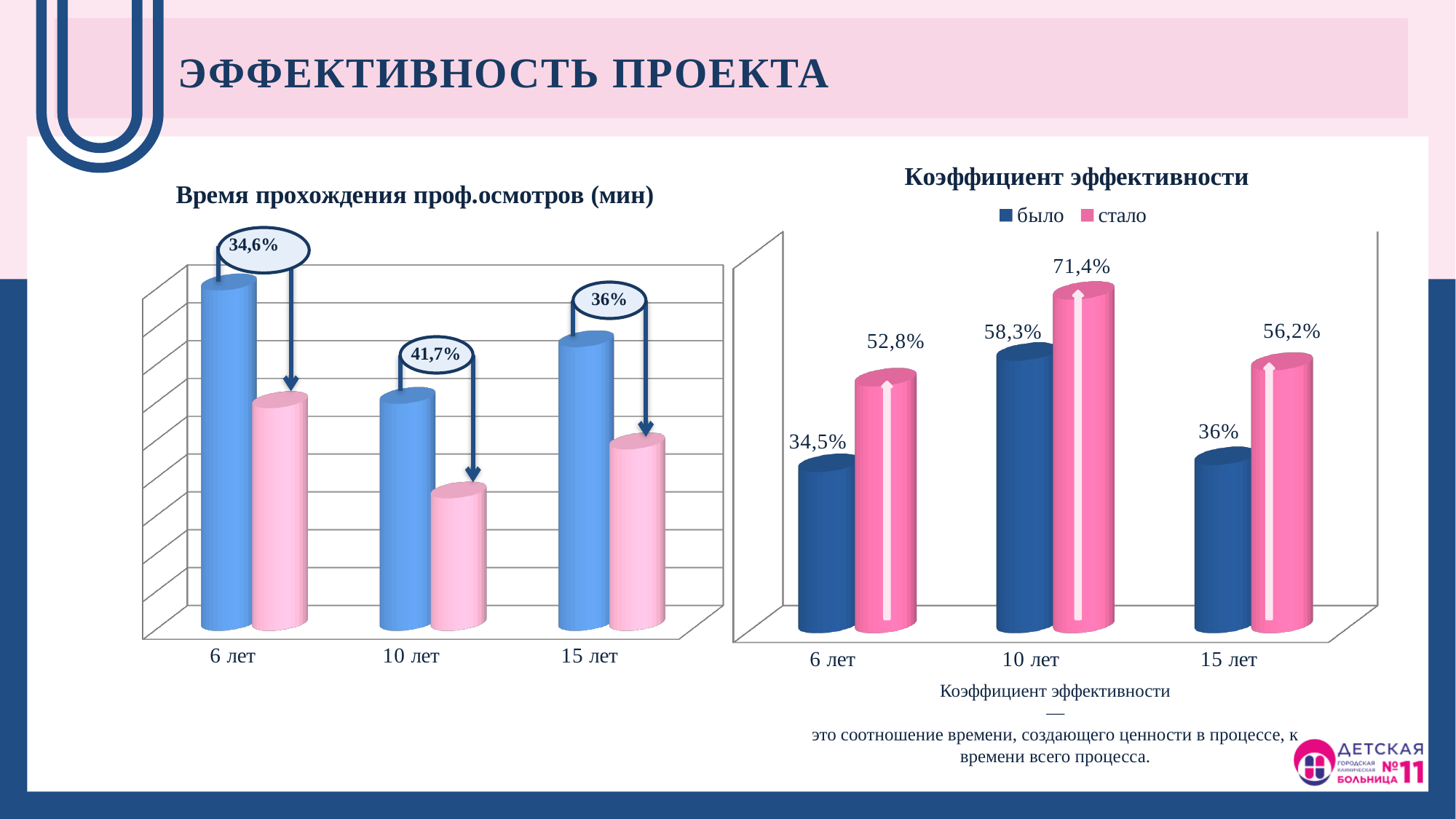
What kind of chart is the chart titled 'Время прохождения проф.осмотров (мин)'? Bar chart In the chart titled 'Коэффициент эффективности', what is the difference between 'стало' and 'было' at '10 лет'? 13,1% In the chart titled 'Коэффициент эффективности', what is the value for 'стало' at '6 лет'? 52,8% In the chart titled 'Время прохождения проф.осмотров (мин)', which category has the tallest blue bar? 6 лет How many categories are shown on the x axis of the chart titled 'Время прохождения проф.осмотров (мин)'? 3 In the chart titled 'Коэффициент эффективности', what is the value for 'было' at '10 лет'? 58,3% In the chart titled 'Коэффициент эффективности', which category has the highest 'стало' value? 10 лет In the chart titled 'Коэффициент эффективности', what is the difference between 'стало' and 'было' at '15 лет'? 20,2% In the chart titled 'Коэффициент эффективности', what is the value for 'стало' at '15 лет'? 56,2% In the chart titled 'Коэффициент эффективности', which is larger: 'было' at '10 лет' or 'стало' at '6 лет'? было at 10 лет In the chart titled 'Коэффициент эффективности', which category has the lowest 'было' value? 6 лет How many series does the legend of the chart titled 'Коэффициент эффективности' list? 2